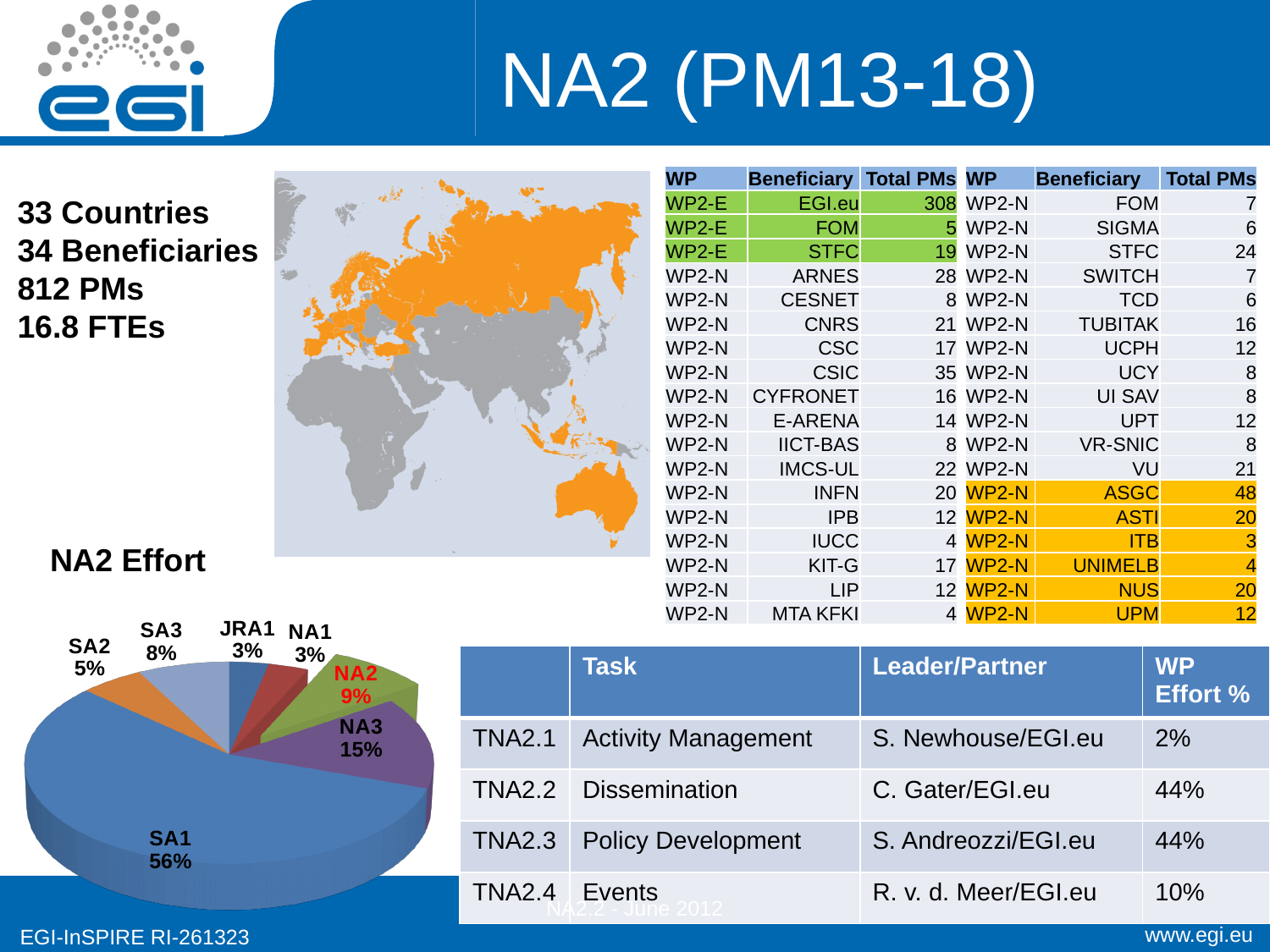
In the NA2 Effort pie chart, what share do JRA1 and NA1 each have? 3% In the NA2 Effort pie chart, what share does SA3 have? 8% In the NA2 Effort pie chart, what share does SA2 have? 5% What type of chart is the NA2 Effort chart? pie chart In the NA2 Effort pie chart, which is larger, NA3 or SA3? NA3 What is the title of the pie chart on the slide? NA2 Effort In the NA2 Effort pie chart, what share does NA3 have? 15% Which slice is the largest in the NA2 Effort pie chart? SA1 In the NA2 Effort pie chart, what is the difference between the SA1 share and the NA3 share? 41% In the NA2 Effort pie chart, what share does SA1 have? 56% In the NA2 Effort pie chart, what share does NA2 have? 9% How many slices does the NA2 Effort pie chart have? 7